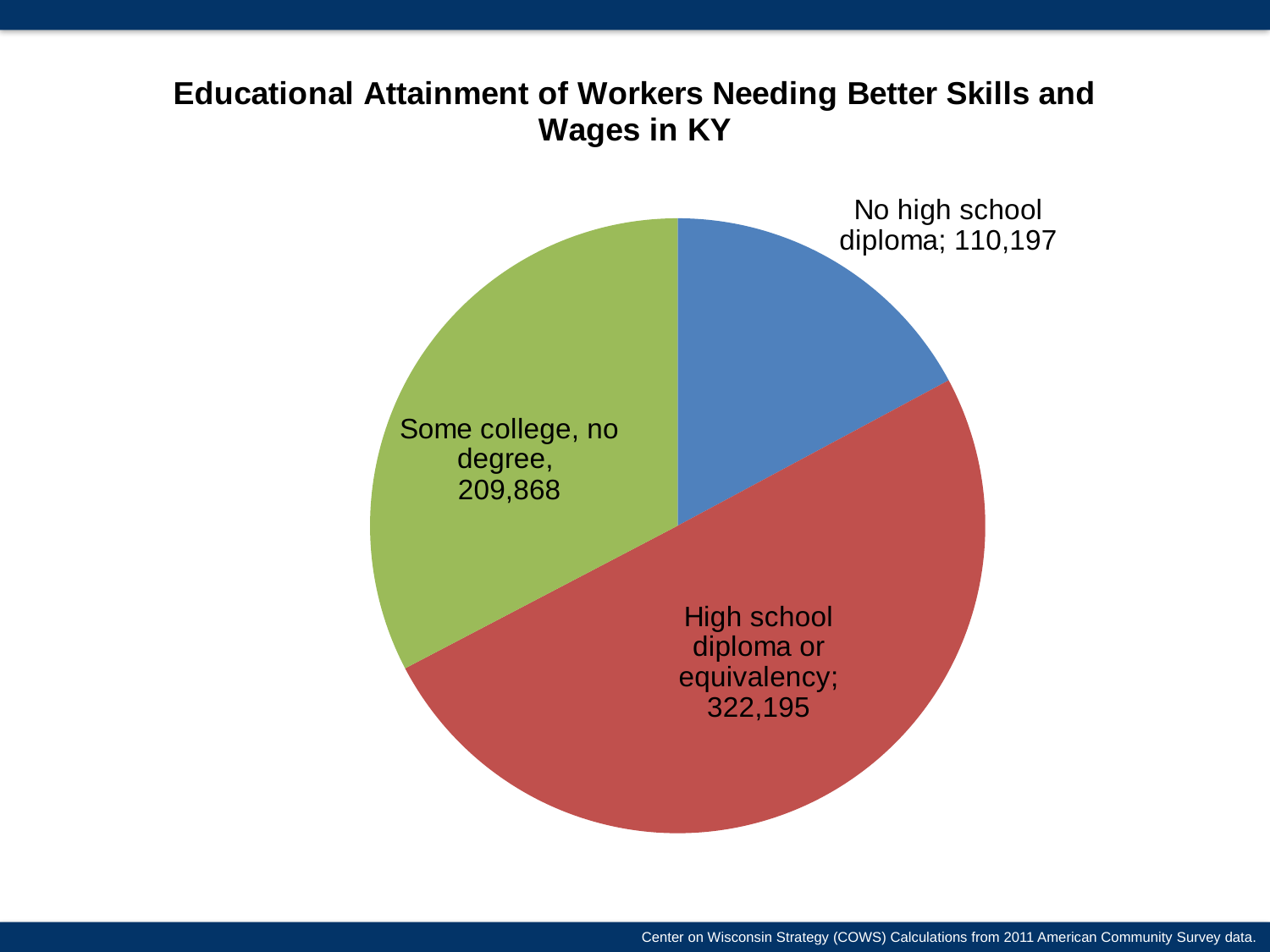
What is the title of the chart? Educational Attainment of Workers Needing Better Skills and Wages in KY What is the total number of workers across all three slices of the pie? 642,260 How many slices does the pie chart have? 3 How many workers needing better skills and wages in KY have no high school diploma? 110,197 What is the value for the 'High school diploma or equivalency' slice? 322,195 What is the difference between the 'High school diploma or equivalency' value and the 'No high school diploma' value? 211,998 What is the difference between the 'Some college, no degree' value and the 'No high school diploma' value? 99,671 Which educational attainment category has the largest slice of the pie? High school diploma or equivalency Which is larger: the 'Some college, no degree' slice or the 'No high school diploma' slice? Some college, no degree What type of chart is shown on the slide? Pie chart Which educational attainment category has the smallest slice of the pie? No high school diploma What is the value for the 'Some college, no degree' slice? 209,868